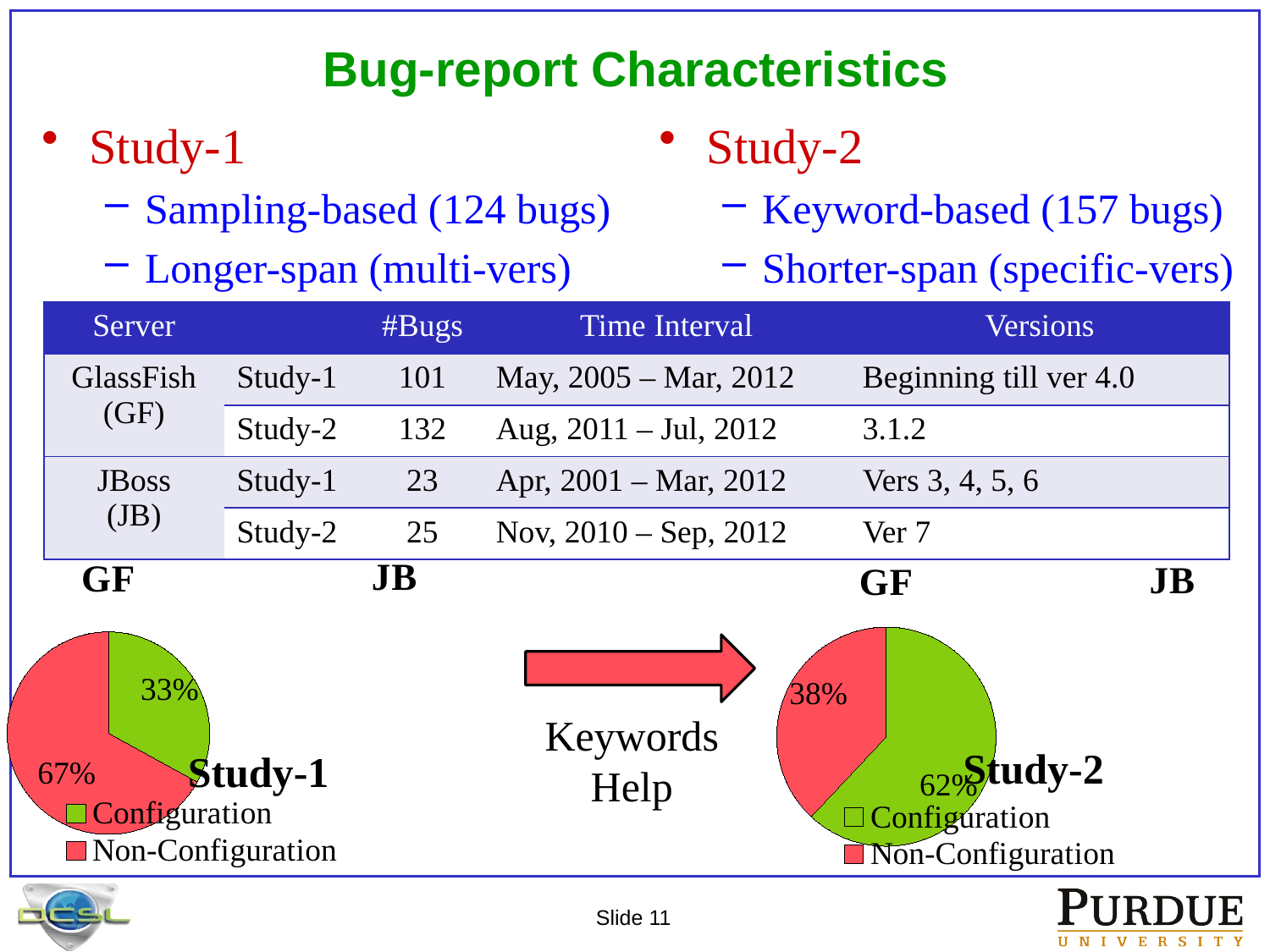
In the left pie chart (Study-1), what share is Configuration? 33% In the left pie chart (Study-1), what share is Non-Configuration? 67% How many slices does the right pie chart (Study-2) have? 2 In the left pie chart (Study-1), what colour is the Configuration slice? green In the right pie chart (Study-2), what is the difference between the Configuration and Non-Configuration shares? 24% In the left pie chart (Study-1), what is the difference between the Non-Configuration and Configuration shares? 34% What kind of chart is the left chart labelled Study-1? pie chart In the right pie chart (Study-2), which slice is the smallest? Non-Configuration In the right pie chart (Study-2), what share is Non-Configuration? 38% In the left pie chart (Study-1), which slice is the largest? Non-Configuration Is the Configuration share larger in the left pie chart (Study-1) or the right pie chart (Study-2)? Study-2 In the right pie chart (Study-2), what share is Configuration? 62%